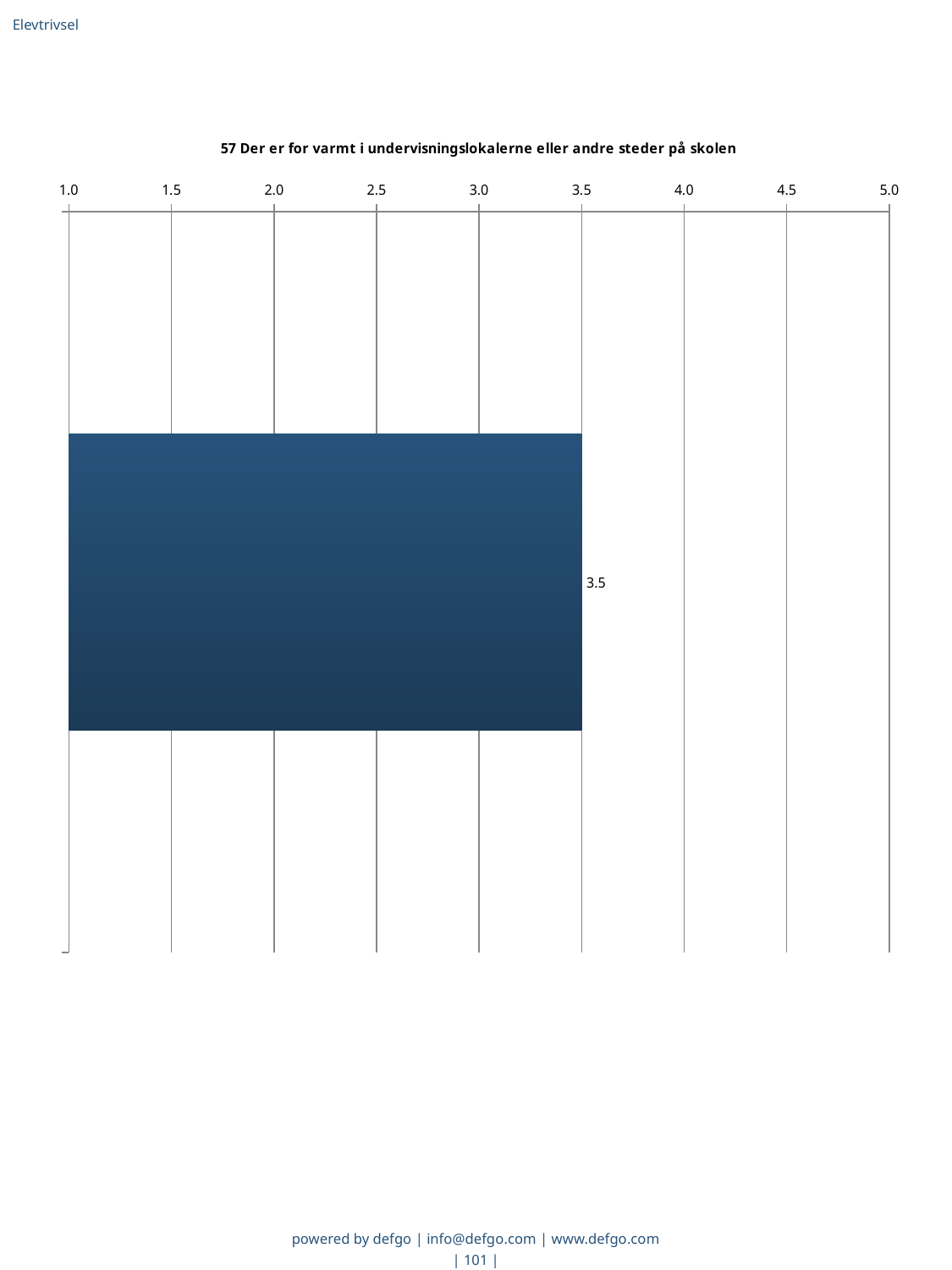
What value is shown by the bar in the chart? 3.5 Is the value of the bar greater or less than 4.0? less What is the highest value shown on the chart's axis? 5.0 What is the title of the chart? 57 Der er for varmt i undervisningslokalerne eller andre steder på skolen How many bars are plotted in the chart? 1 What kind of chart is shown on the slide? bar chart Is the value of the bar greater or less than 3.0? greater Are the bars in the chart horizontal or vertical? horizontal